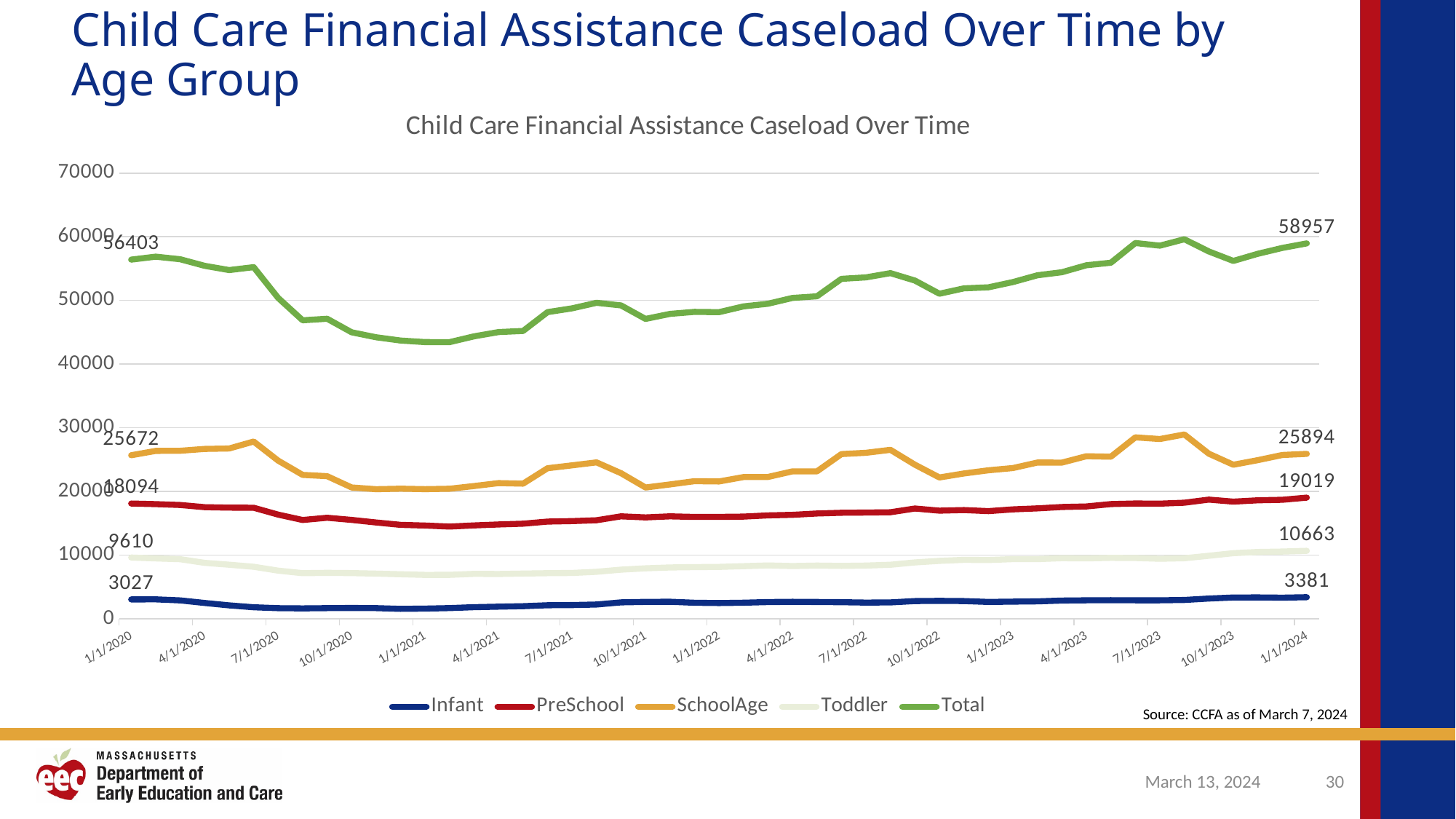
Which is larger at 1/1/2024: the SchoolAge value or the PreSchool value? SchoolAge What is the Infant caseload value labelled at 1/1/2020? 3027 What type of chart is shown on the slide? line chart What is the SchoolAge caseload value labelled at 1/1/2024? 25894 What colour is the Total line in the chart? green Which series has the lowest values throughout the chart? Infant How many series does the legend list? 5 Is the Total caseload at 1/1/2021 greater or less than 50000? less What is the difference between the PreSchool values labelled at 1/1/2024 (19019) and 1/1/2020 (18094)? 925 What is the Total caseload value labelled at 1/1/2024? 58957 What is the Toddler caseload value labelled at 1/1/2020? 9610 By how much did the Total caseload change from 1/1/2020 (56403) to 1/1/2024 (58957)? 2554